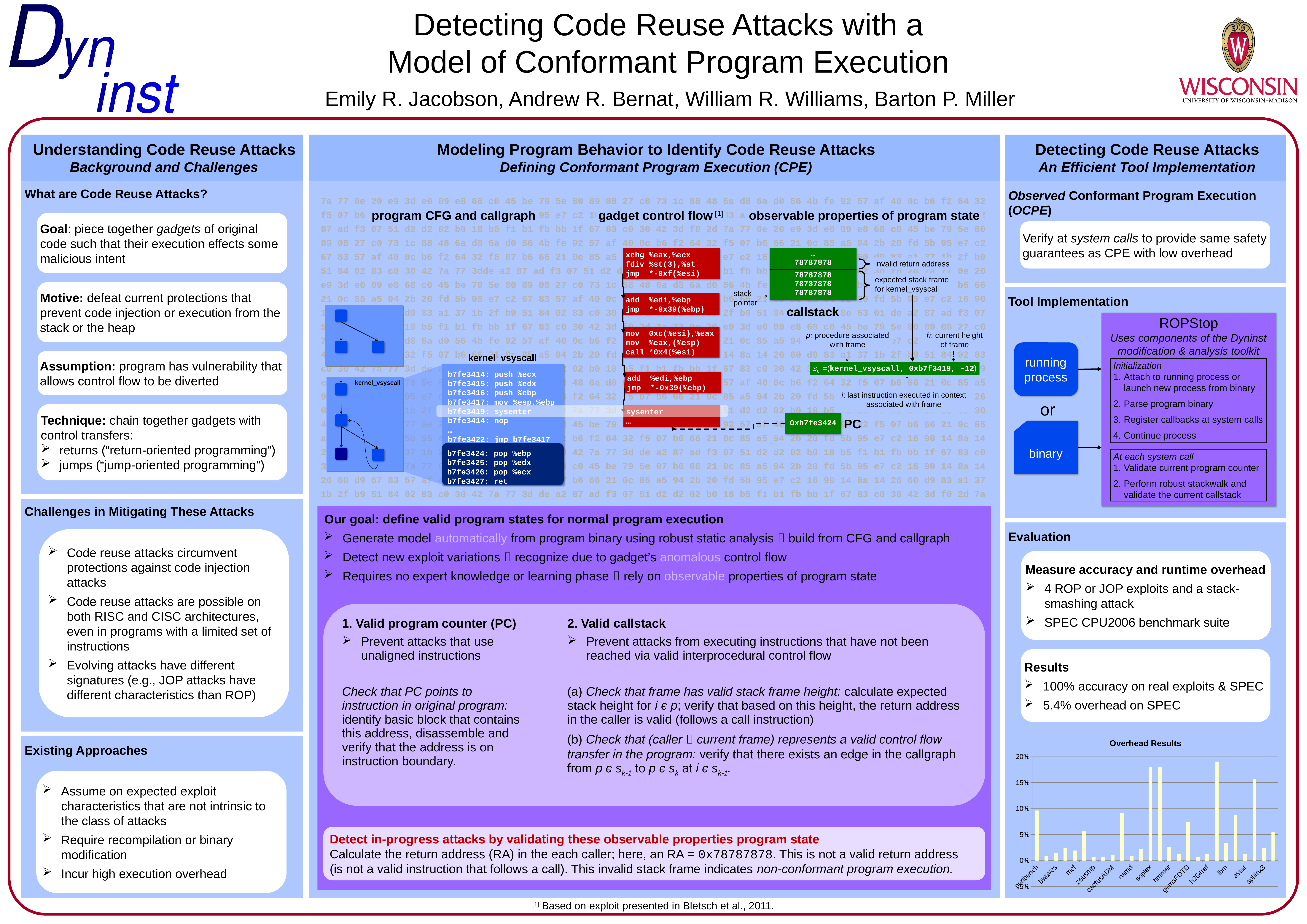
What is the highest value shown on the y axis of the Overhead Results chart? 20% In the Overhead Results chart, is the value for namd greater or less than 5%? less What kind of chart is the Overhead Results chart? bar chart In the Overhead Results chart, is the value for perlbench greater or less than 15%? less What is the title of the chart in the Evaluation section? Overhead Results In the Overhead Results chart, is the value for astar greater or less than 5%? less How many benchmark names are labeled on the x axis of the Overhead Results chart? 13 In the Overhead Results chart, which is larger, the value for perlbench or the value for bwaves? perlbench